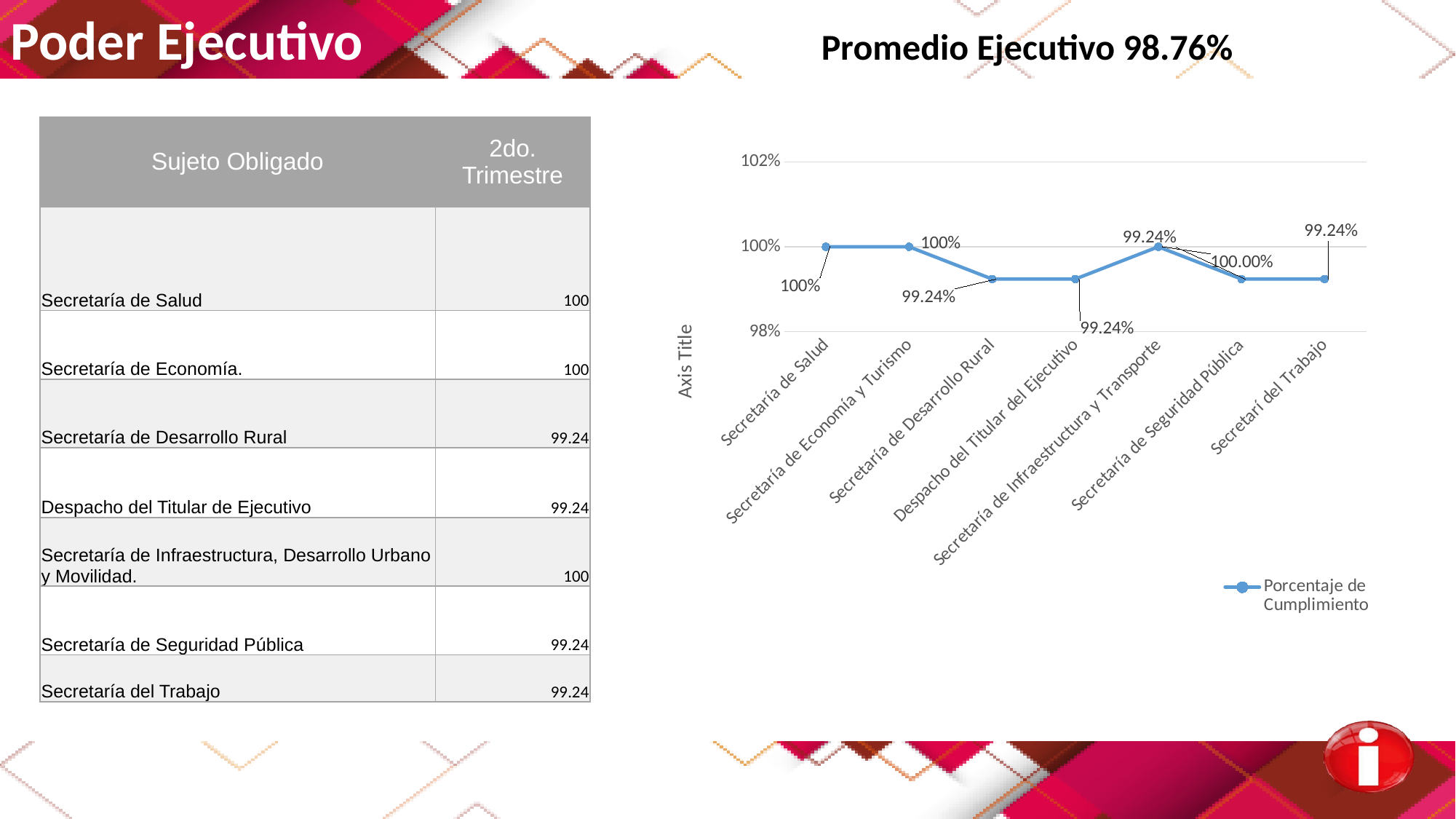
How many categories are plotted along the x axis of the chart? 7 What kind of chart is shown on the slide? line chart Is the value for Secretaría de Salud greater or less than 98%? greater What is the value plotted for Despacho del Titular del Ejecutivo? 99.24% What is the difference between the value for Secretaría de Salud and the value for Secretaría de Desarrollo Rural? 0.76% What is the value plotted for Secretaría de Economía y Turismo? 100% What is the label on the vertical axis of the chart? Axis Title Which is larger, the value for Secretaría de Salud or the value for Secretaría de Desarrollo Rural? Secretaría de Salud How many series does the chart legend list? 1 What is the value plotted for Secretaría de Desarrollo Rural? 99.24% What is the name of the series shown in the chart legend? Porcentaje de Cumplimiento What is the value plotted for Secretaría de Salud? 100%